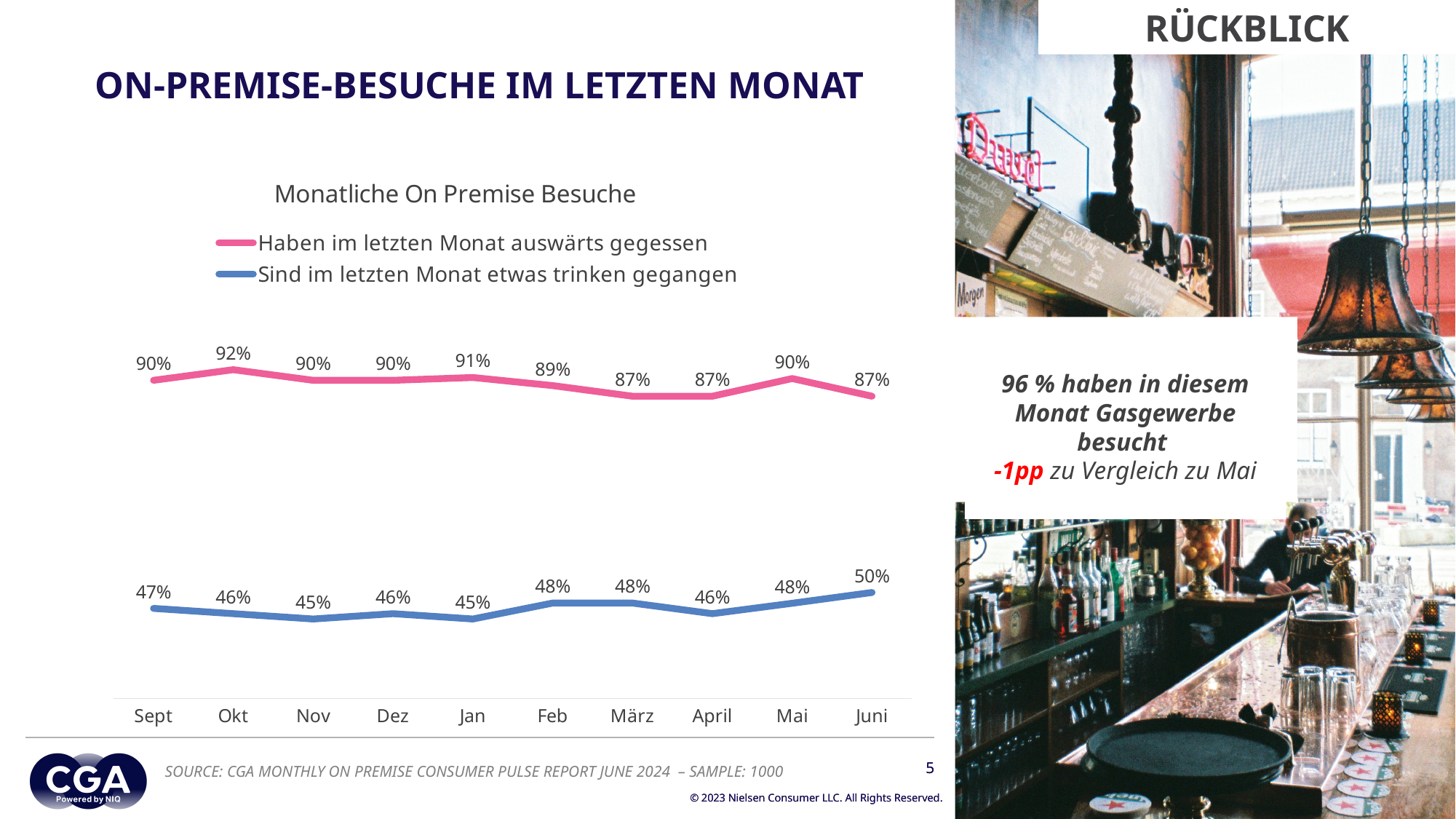
What is the value for 'Haben im letzten Monat auswärts gegessen' in Okt? 92% In which month is the value for 'Sind im letzten Monat etwas trinken gegangen' highest? Juni What is the difference between the two series' values in Juni? 37 percentage points What is the title of the chart? Monatliche On Premise Besuche How many months are shown on the x axis of the chart? 10 In which month is the value for 'Haben im letzten Monat auswärts gegessen' highest? Okt How many series does the chart's legend list? 2 What is the value for 'Sind im letzten Monat etwas trinken gegangen' in Juni? 50% Which series has the larger value in Sept: 'Haben im letzten Monat auswärts gegessen' or 'Sind im letzten Monat etwas trinken gegangen'? Haben im letzten Monat auswärts gegessen What is the difference between the 'Haben im letzten Monat auswärts gegessen' value in Okt and in Juni? 5 percentage points What type of chart is shown on the slide? Line chart What colour is the line for 'Sind im letzten Monat etwas trinken gegangen'? Blue